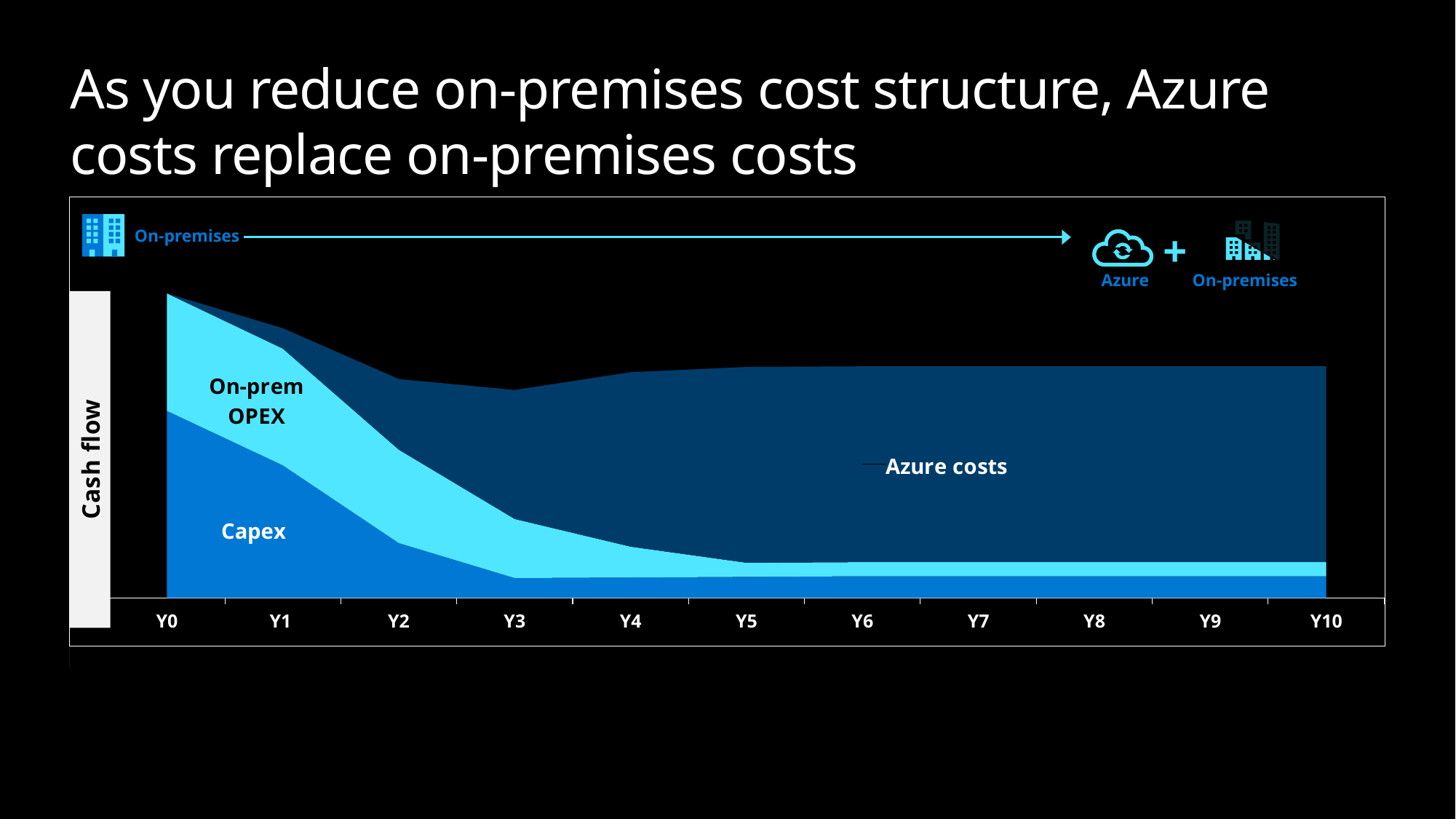
What is the last category label on the x axis? Y10 Does the Capex area rise or fall from Y0 to Y10? Fall What kind of chart is shown on the slide? Stacked area chart At which year is the Capex area at its highest? Y0 At which year is the Azure costs area at its lowest? Y0 At Y0, which is larger: the Capex area or the On-prem OPEX area? Capex Does the Azure costs area rise or fall from Y0 to Y4? Rise What is the first category label on the x axis? Y0 At Y8, which is larger: the Azure costs area or the Capex area? Azure costs How many cost series are labelled in the chart? 3 How many year points are shown along the x axis of the chart? 11 Does the On-prem OPEX area rise or fall from Y0 to Y10? Fall